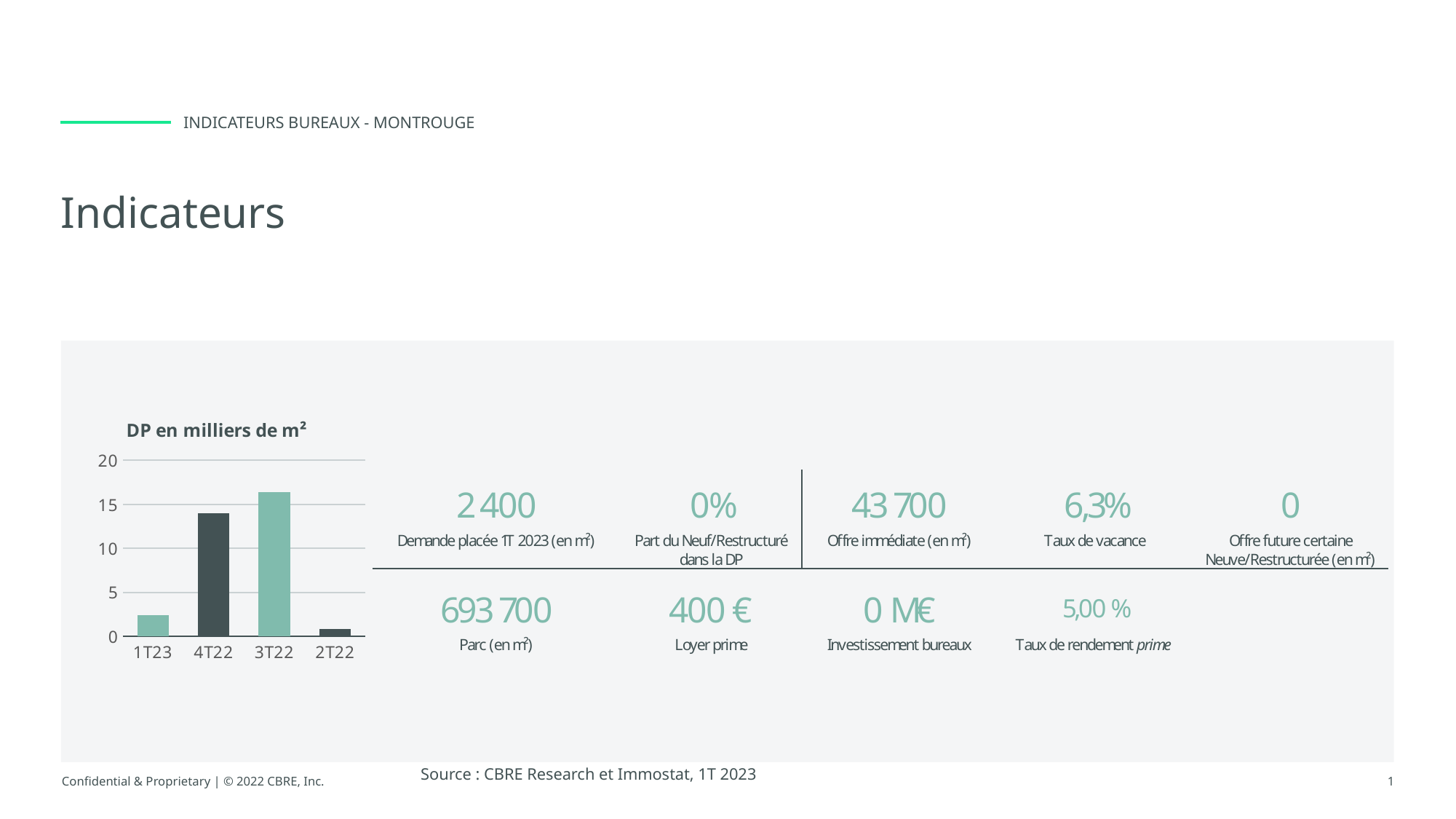
Which is larger in the chart, the value for 4T22 or the value for 3T22? 3T22 What is the title of the chart? DP en milliers de m² Is the value for 3T22 greater or less than 15? greater Is the value for 1T23 greater or less than 5? less What is the highest value shown on the y axis of the chart? 20 Is the value for 4T22 greater or less than 10? greater Which category has the highest bar in the chart? 3T22 Which category has the lowest bar in the chart? 2T22 How many categories are shown on the x axis of the chart? 4 What kind of chart is shown on the slide? bar chart Which is larger in the chart, the value for 1T23 or the value for 2T22? 1T23